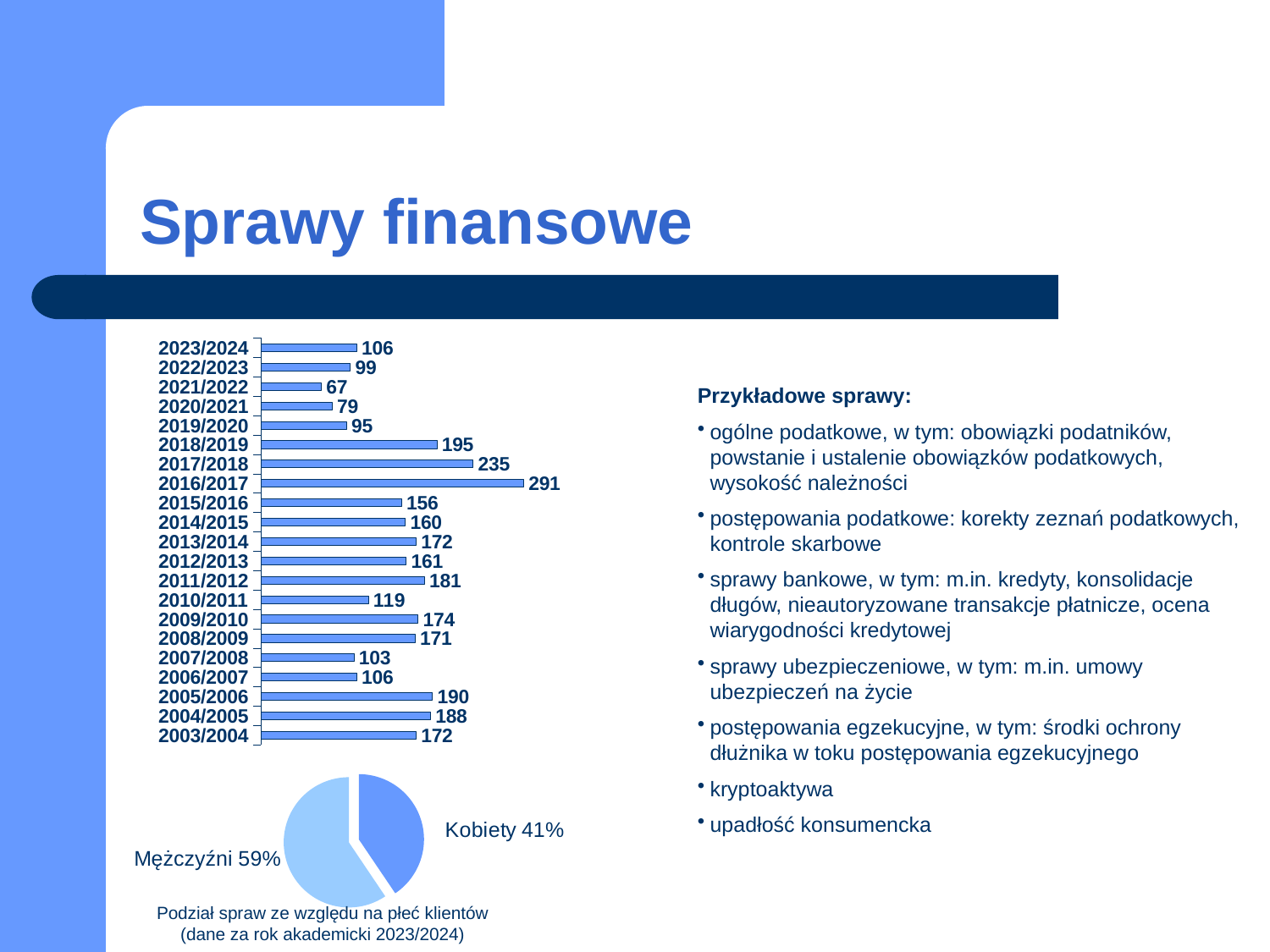
In the bar chart, which academic year has the lowest value? 2021/2022 How many academic years are shown in the bar chart? 21 In the bar chart, what is the value for 2010/2011? 119 In the pie chart, what share is labelled Kobiety? 41% What kind of chart is the chart at the top left of the slide? bar chart In the bar chart, what is the difference between the values for 2017/2018 and 2018/2019? 40 What kind of chart is the chart at the bottom left of the slide? pie chart In the pie chart, what share is labelled Mężczyźni? 59% In the bar chart, which is larger, the value for 2005/2006 or the value for 2004/2005? 2005/2006 In the bar chart, which academic year has the highest value? 2016/2017 In the bar chart, what is the value for 2016/2017? 291 In the bar chart, what is the value for 2023/2024? 106